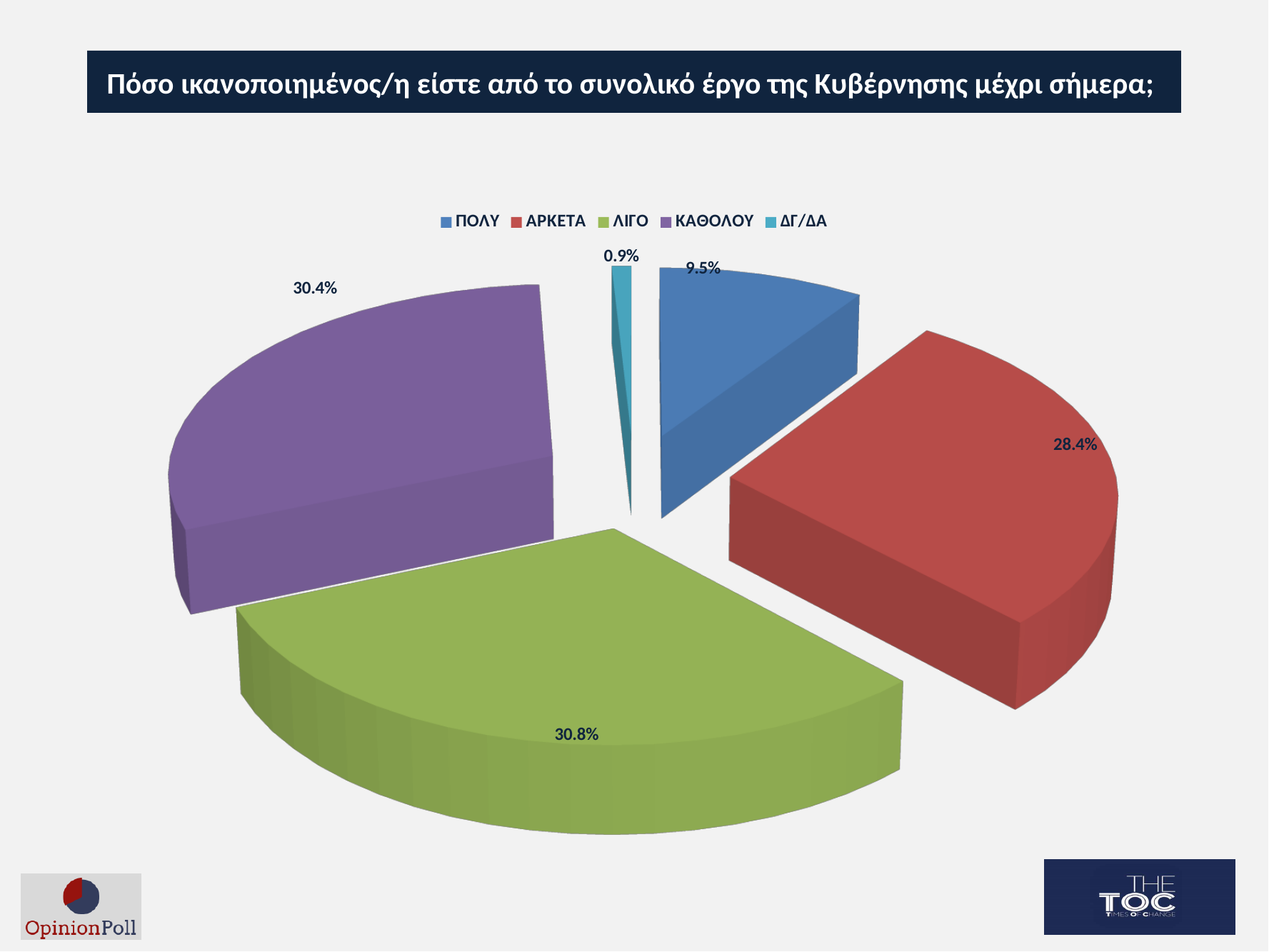
What percentage of respondents answered ΠΟΛΥ? 9.5% Which is larger, the share for ΑΡΚΕΤΑ or the share for ΠΟΛΥ? ΑΡΚΕΤΑ What is the difference in percentage points between ΚΑΘΟΛΟΥ and ΑΡΚΕΤΑ? 2.0 What colour is the slice for ΚΑΘΟΛΟΥ? Purple What percentage of respondents answered ΑΡΚΕΤΑ? 28.4% Which response category has the smallest share of the pie? ΔΓ/ΔΑ How many categories does the pie chart show? 5 What percentage of respondents answered ΔΓ/ΔΑ? 0.9% What kind of chart is shown on the slide? Pie chart Which response category has the largest share of the pie? ΛΙΓΟ What percentage of respondents answered ΚΑΘΟΛΟΥ? 30.4% What is the difference in percentage points between ΛΙΓΟ and ΠΟΛΥ? 21.3